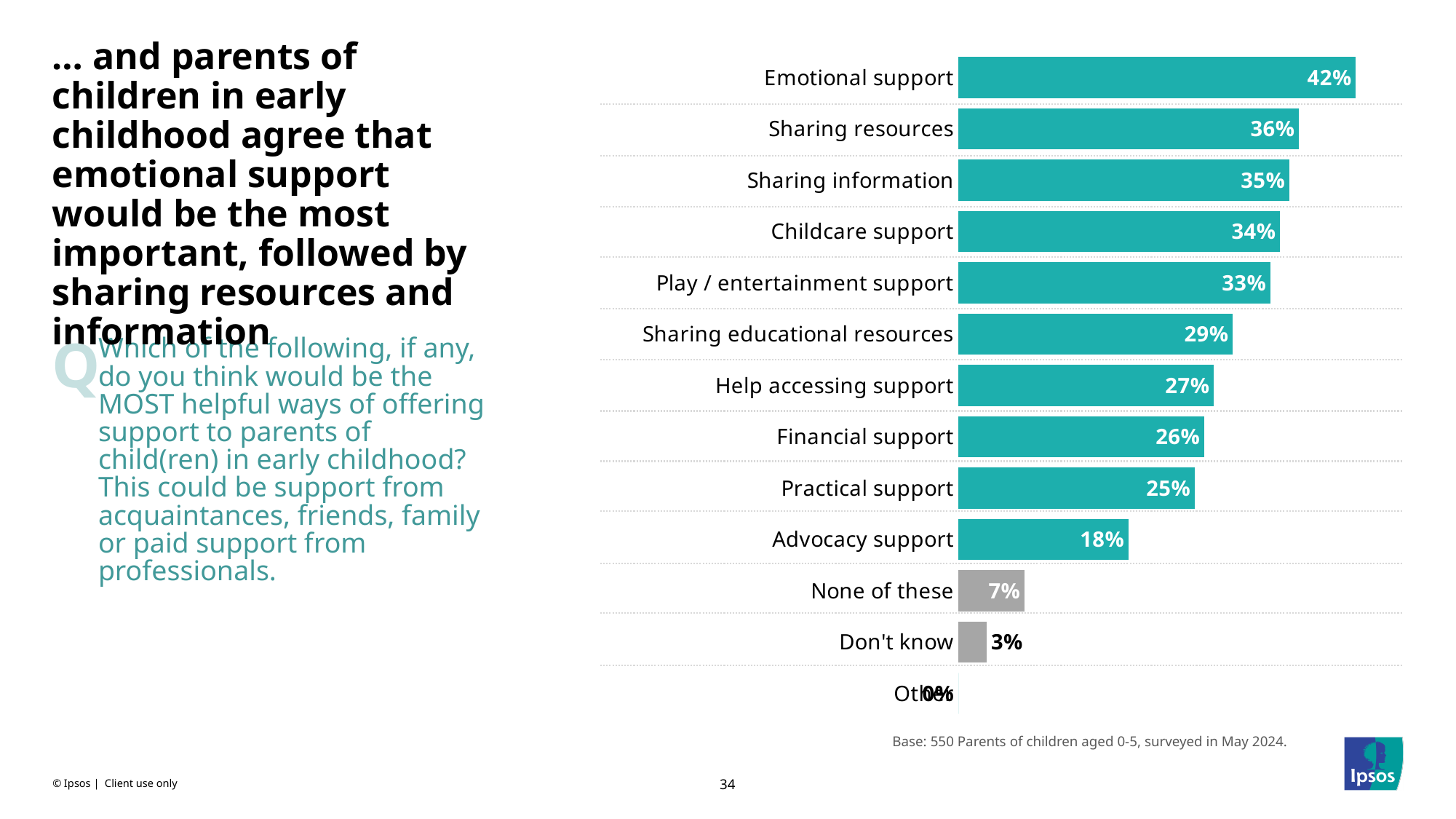
What is the difference in percentage points between Sharing educational resources and Practical support? 4 What is the difference in percentage points between Emotional support and Sharing resources? 6 Which is larger, the value for Financial support or the value for Help accessing support? Help accessing support What percentage is shown for Advocacy support? 18% What is the value for None of these? 7% Which is larger, the value for Play / entertainment support or the value for Advocacy support? Play / entertainment support Which of the teal-coloured support categories has the lowest value? Advocacy support Which category has the highest value in the chart? Emotional support What percentage of parents chose Emotional support as one of the most helpful ways of offering support? 42% What is the value shown for Don't know? 3% What kind of chart is shown on the slide? Bar chart What is the value shown for Childcare support? 34%